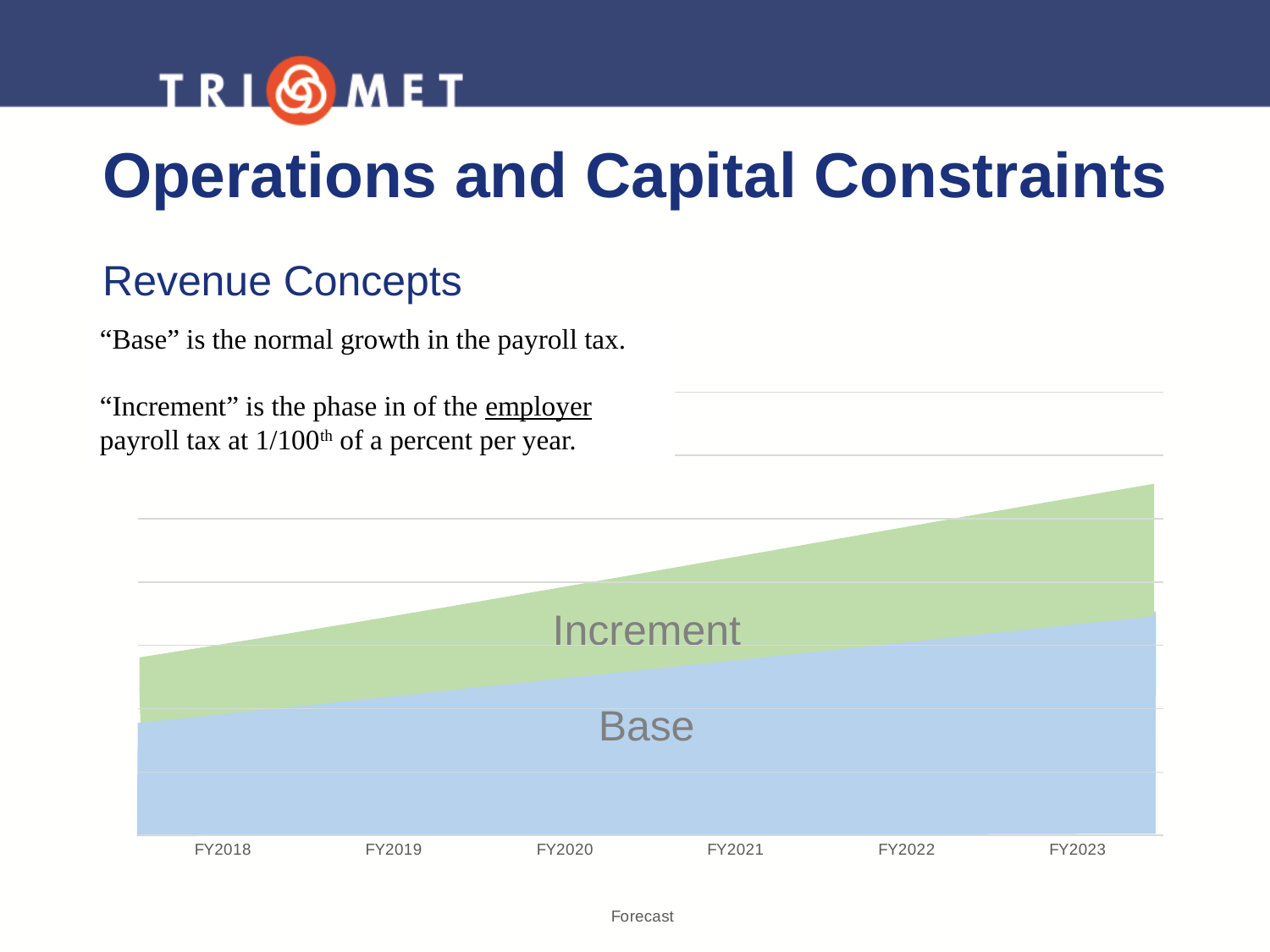
Does the total of Base plus Increment rise or fall from FY2018 to FY2023? Rise Does the Base series rise or fall across the fiscal years shown? Rise How many series are plotted in the chart? 2 How many fiscal years are shown along the x axis of the chart? 6 Which fiscal year is the first category on the x axis? FY2018 Which fiscal year is the last category on the x axis? FY2023 In FY2023, which series is larger, Base or Increment? Base What are the names of the two series plotted in the chart? Base and Increment What kind of chart is shown on the slide? Area chart What is the label shown beneath the x axis of the chart? Forecast